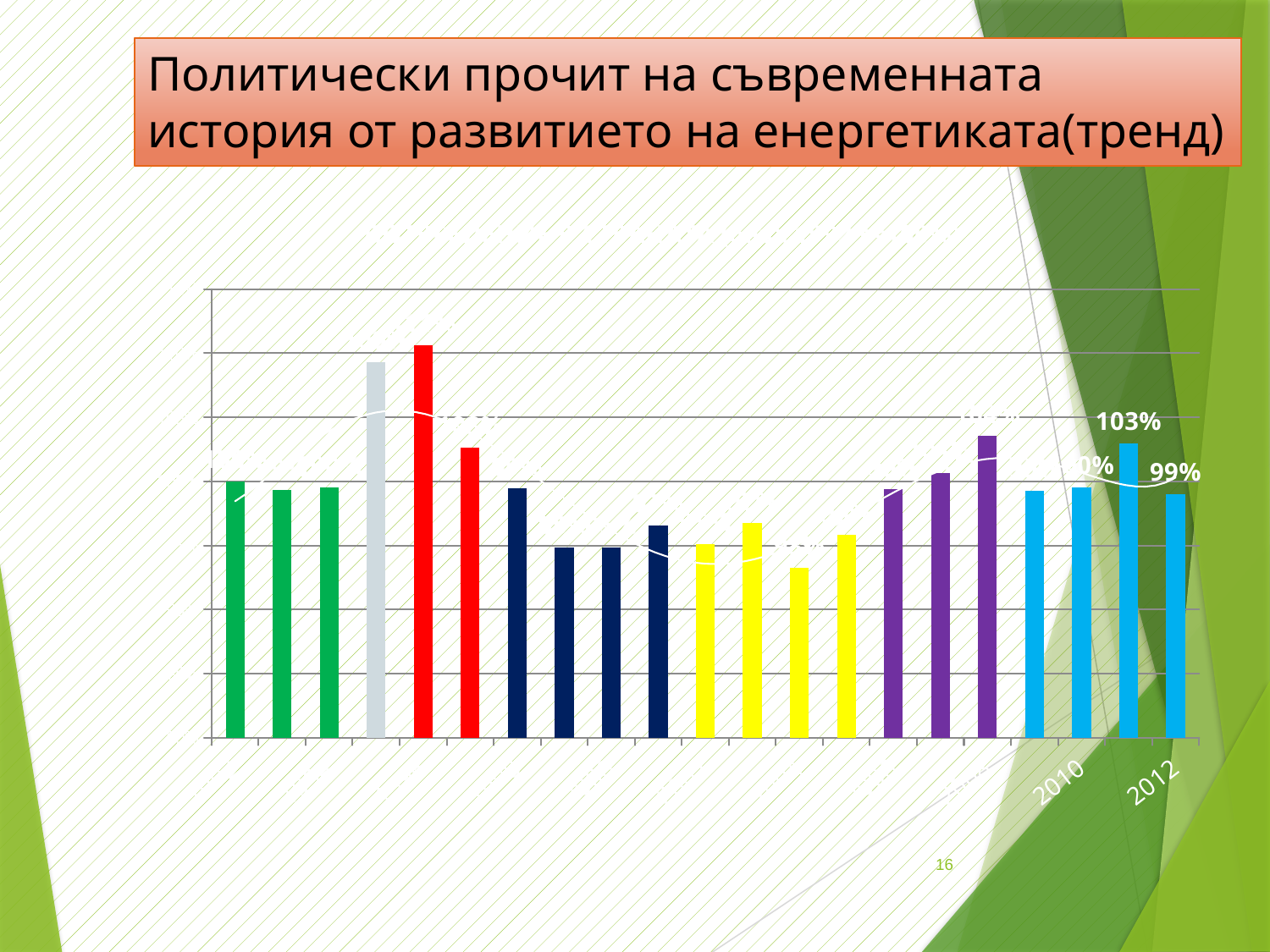
What is the difference between the bar labelled 103% and the bar labelled 99%? 4 percentage points What kind of chart is shown on the slide? bar chart What value is printed above the rightmost bar of the chart? 99% What value is printed above the tallest light-blue bar? 103% What colour is the shortest bar in the chart? yellow How many bars are plotted in the chart in total? 21 What colour is the tallest bar in the chart? red Which is larger, the bar labelled 103% or the bar labelled 99%? 103% How many light-blue bars are there at the right end of the chart? 4